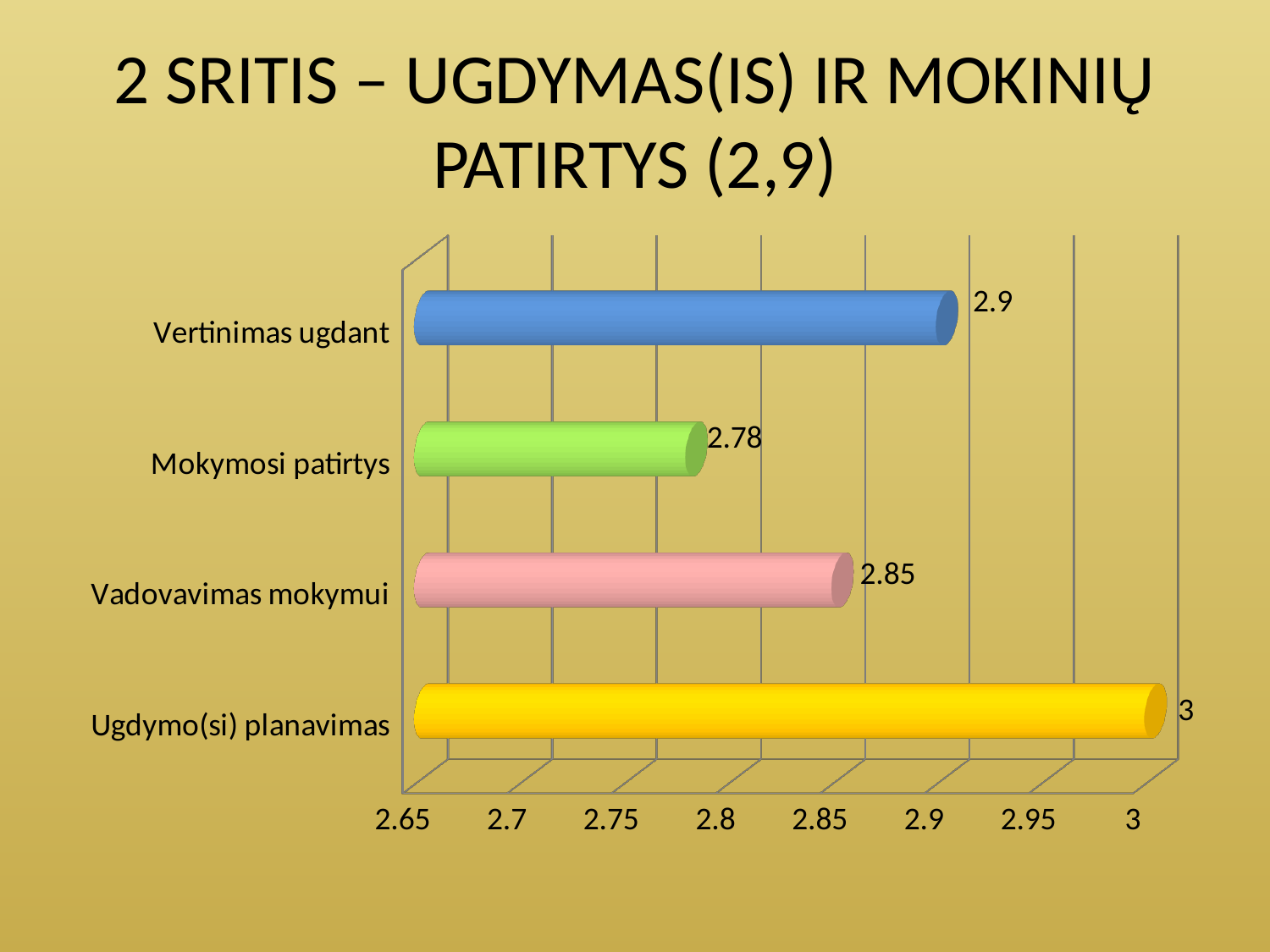
What is the difference between the values for Vertinimas ugdant and Vadovavimas mokymui? 0.05 Which category has the highest value? Ugdymo(si) planavimas What is the difference between the values for Ugdymo(si) planavimas and Mokymosi patirtys? 0.22 How many categories are shown in the chart? 4 What is the value for Mokymosi patirtys? 2.78 Which is larger, the value for Vertinimas ugdant or the value for Vadovavimas mokymui? Vertinimas ugdant What colour is the bar for Ugdymo(si) planavimas? Yellow What is the value for Vertinimas ugdant? 2.9 What is the value for Vadovavimas mokymui? 2.85 What is the value for Ugdymo(si) planavimas? 3 Which category has the lowest value? Mokymosi patirtys What kind of chart is shown on the slide? Bar chart